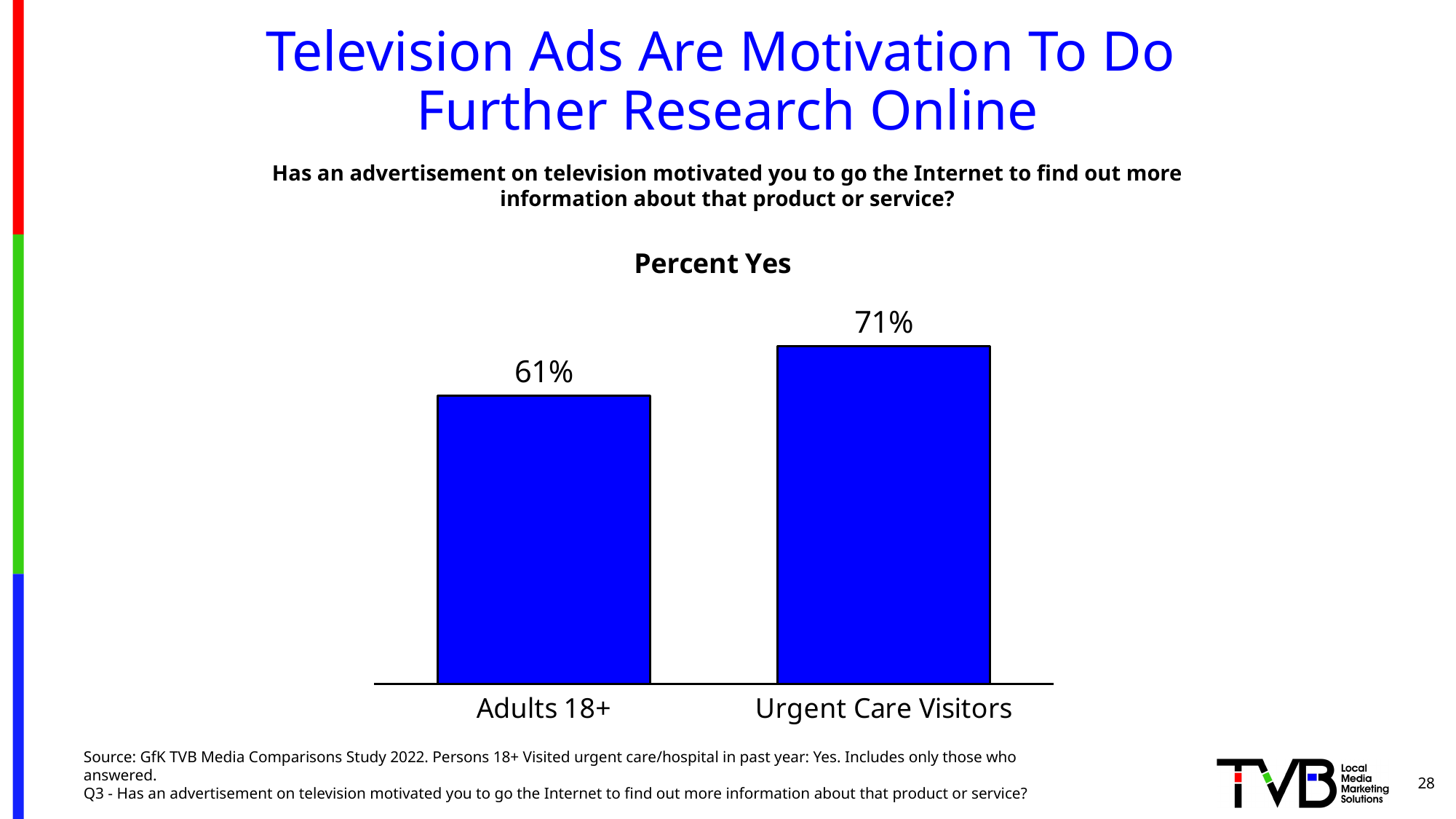
What is the title of the chart? Percent Yes What colour are the bars in the chart? Blue Which category has the lowest Percent Yes value? Adults 18+ What kind of chart is shown on the slide? Bar chart What is the Percent Yes value for Urgent Care Visitors? 71% Which category has the highest Percent Yes value? Urgent Care Visitors What is the Percent Yes value for Adults 18+? 61% How many categories are shown in the chart? 2 Which is larger, the Percent Yes for Adults 18+ or for Urgent Care Visitors? Urgent Care Visitors What is the difference in Percent Yes between Urgent Care Visitors and Adults 18+? 10 percentage points